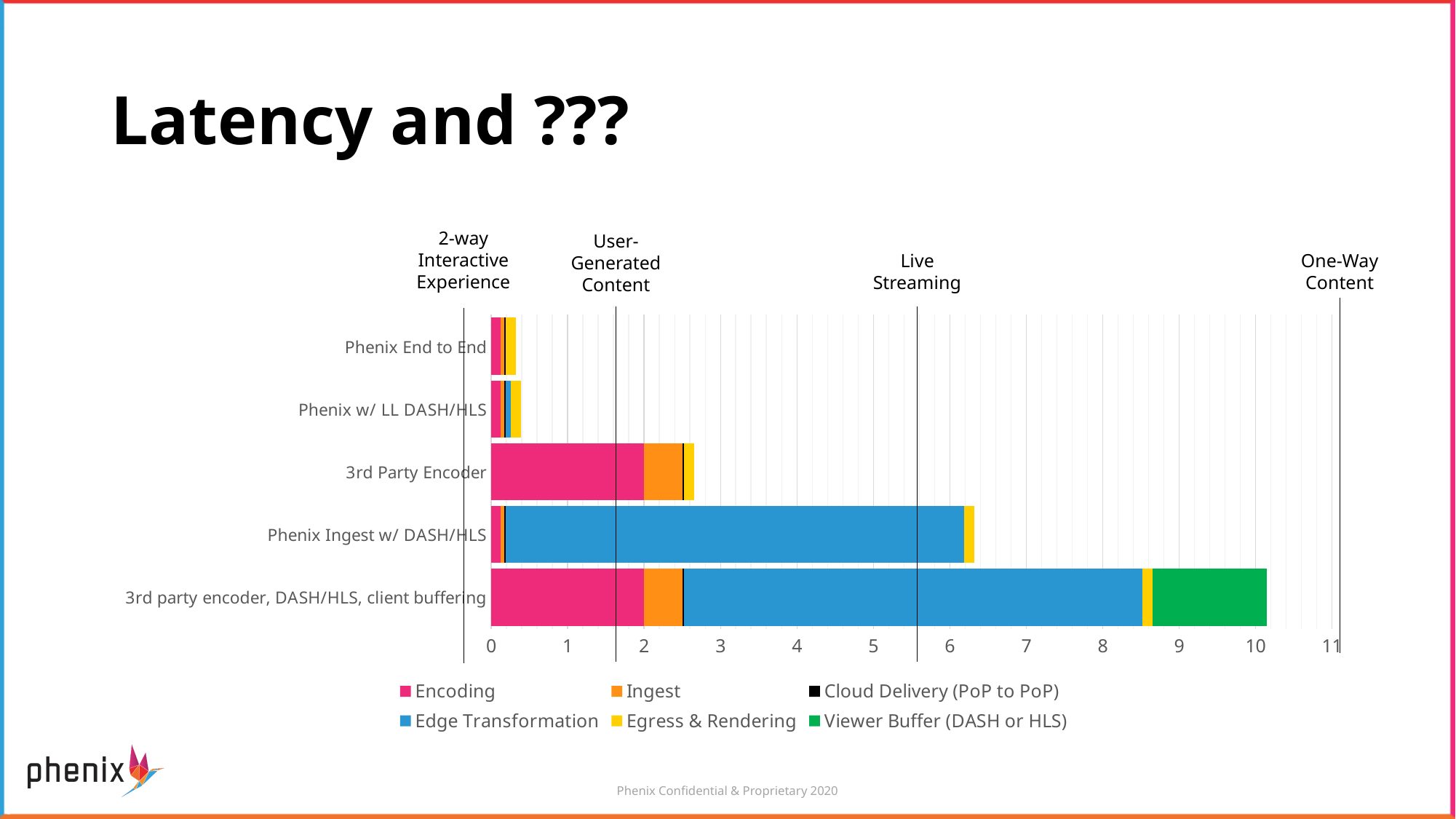
Which total bar is longer: 3rd Party Encoder or Phenix Ingest w/ DASH/HLS? Phenix Ingest w/ DASH/HLS How many categories (bars) does the chart show? 5 Is the total value for Phenix End to End greater or less than 1? less Is the total value for 3rd party encoder, DASH/HLS, client buffering greater or less than 9? greater Which total bar is longer: Phenix w/ LL DASH/HLS or 3rd Party Encoder? 3rd Party Encoder Which category has the longest total bar? 3rd party encoder, DASH/HLS, client buffering What is the title of the slide containing the chart? Latency and ??? Is the total value for Phenix Ingest w/ DASH/HLS greater or less than 5? greater How many series does the legend list? 6 Which legend series is shown in green? Viewer Buffer (DASH or HLS) What kind of chart is shown on the slide? stacked bar chart